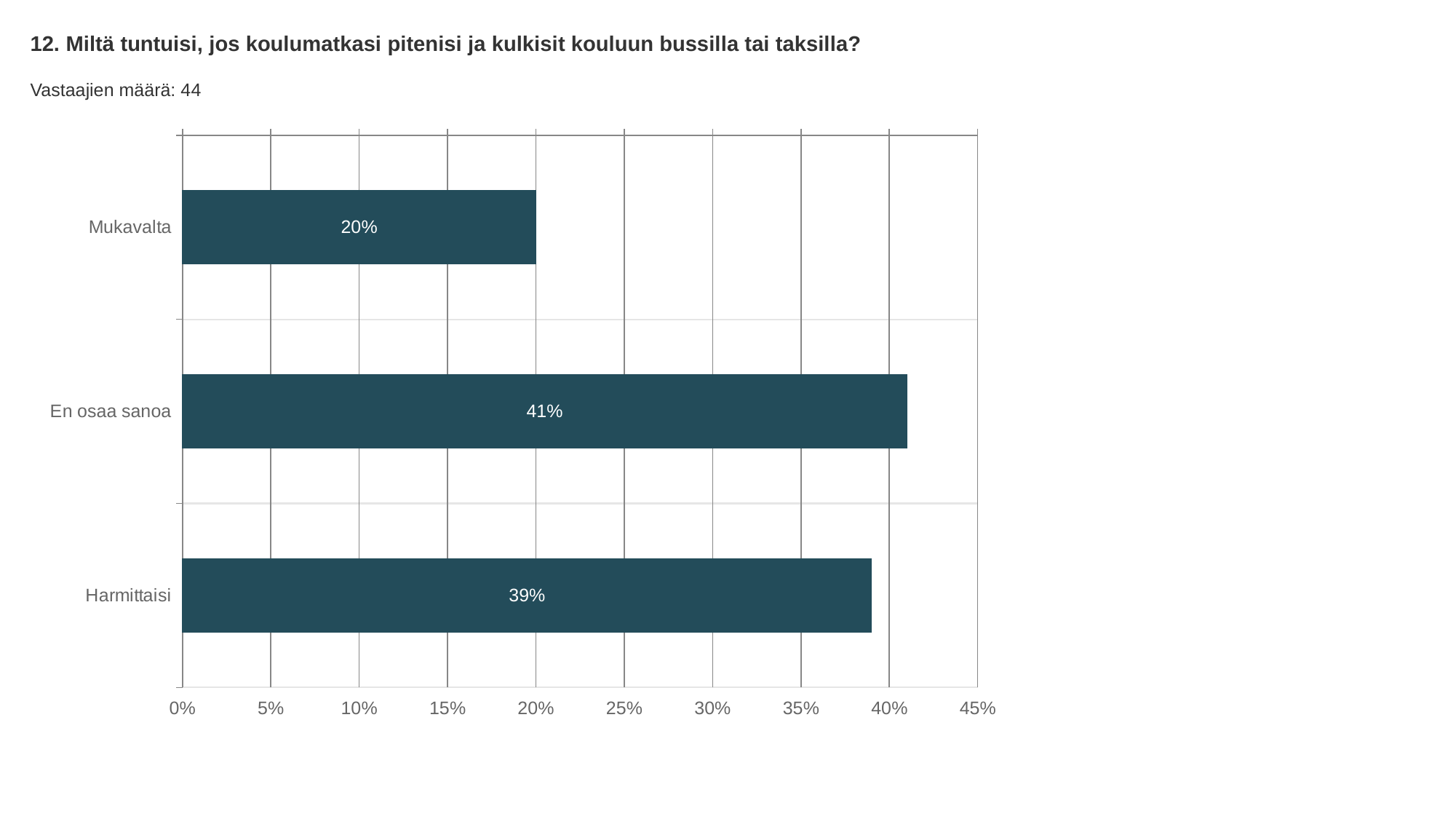
Is the value for Harmittaisi greater or less than 30%? greater What is the value for Mukavalta? 20% How many respondents (Vastaajien määrä) are reported on the slide? 44 How many categories are shown in the chart? 3 What is the difference between the values for Harmittaisi and Mukavalta? 19% What is the value for En osaa sanoa? 41% What is the difference between the values for En osaa sanoa and Mukavalta? 21% Which category has the highest value? En osaa sanoa What kind of chart is shown on the slide? bar chart Which category has the lowest value? Mukavalta What is the value for Harmittaisi? 39% Which is larger, the value for Harmittaisi or the value for Mukavalta? Harmittaisi